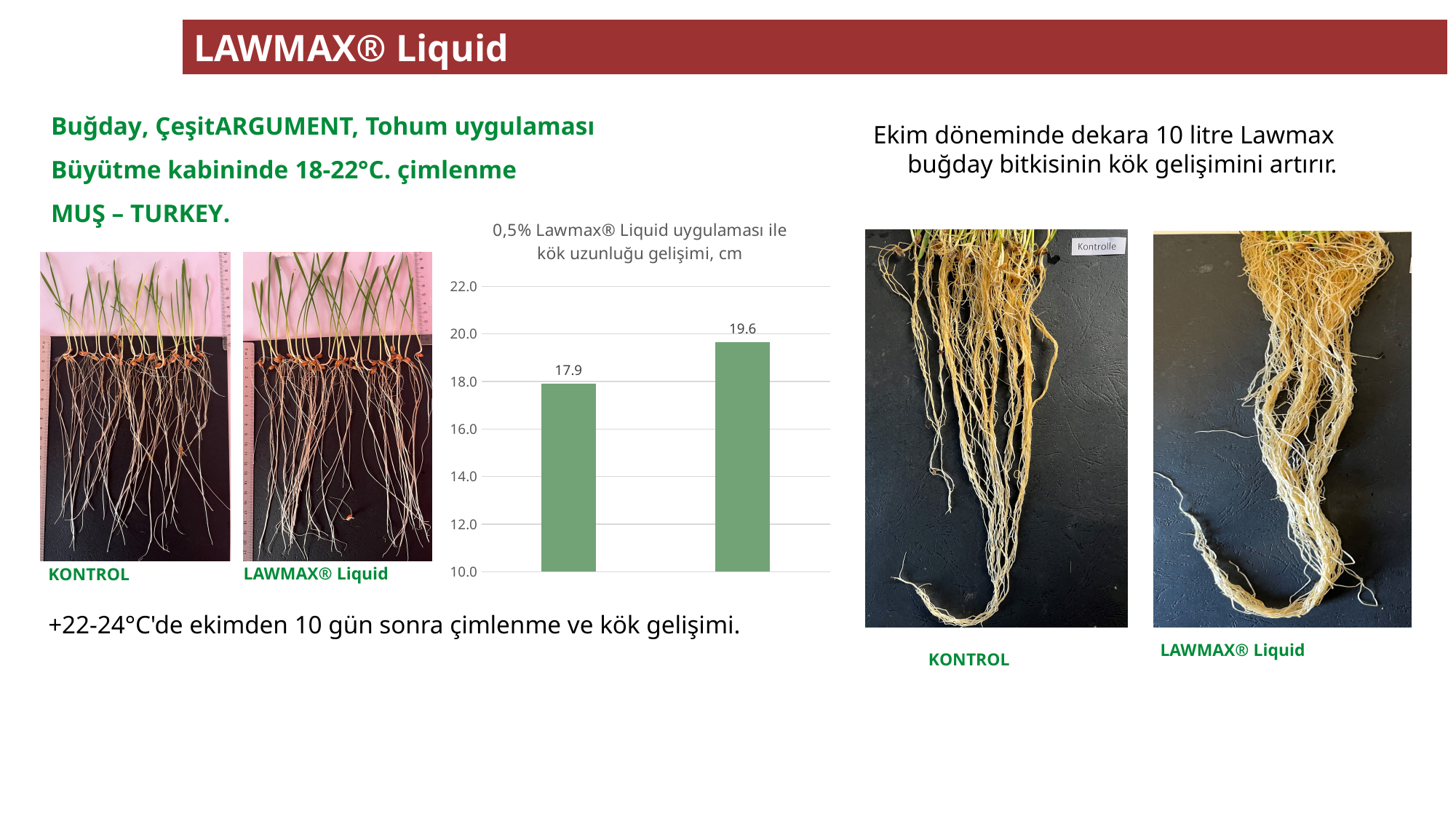
How many bars are plotted in the chart? 2 What is the value of the right bar in the chart? 19.6 What is the value of the left bar in the chart? 17.9 What is the difference between the right bar (19.6) and the left bar (17.9) in the chart? 1.7 What type of chart is shown on the slide? bar chart What is the highest value shown on the chart's vertical axis? 22.0 What is the lowest value shown on the chart's vertical axis? 10.0 What is the title of the chart? 0,5% Lawmax® Liquid uygulaması ile kök uzunluğu gelişimi, cm Is the value of the left bar greater or less than 18.0? less Which bar is taller in the chart, the left one or the right one? the right one Is the value of the right bar greater or less than 20.0? less Do the bar values rise or fall from left to right in the chart? rise